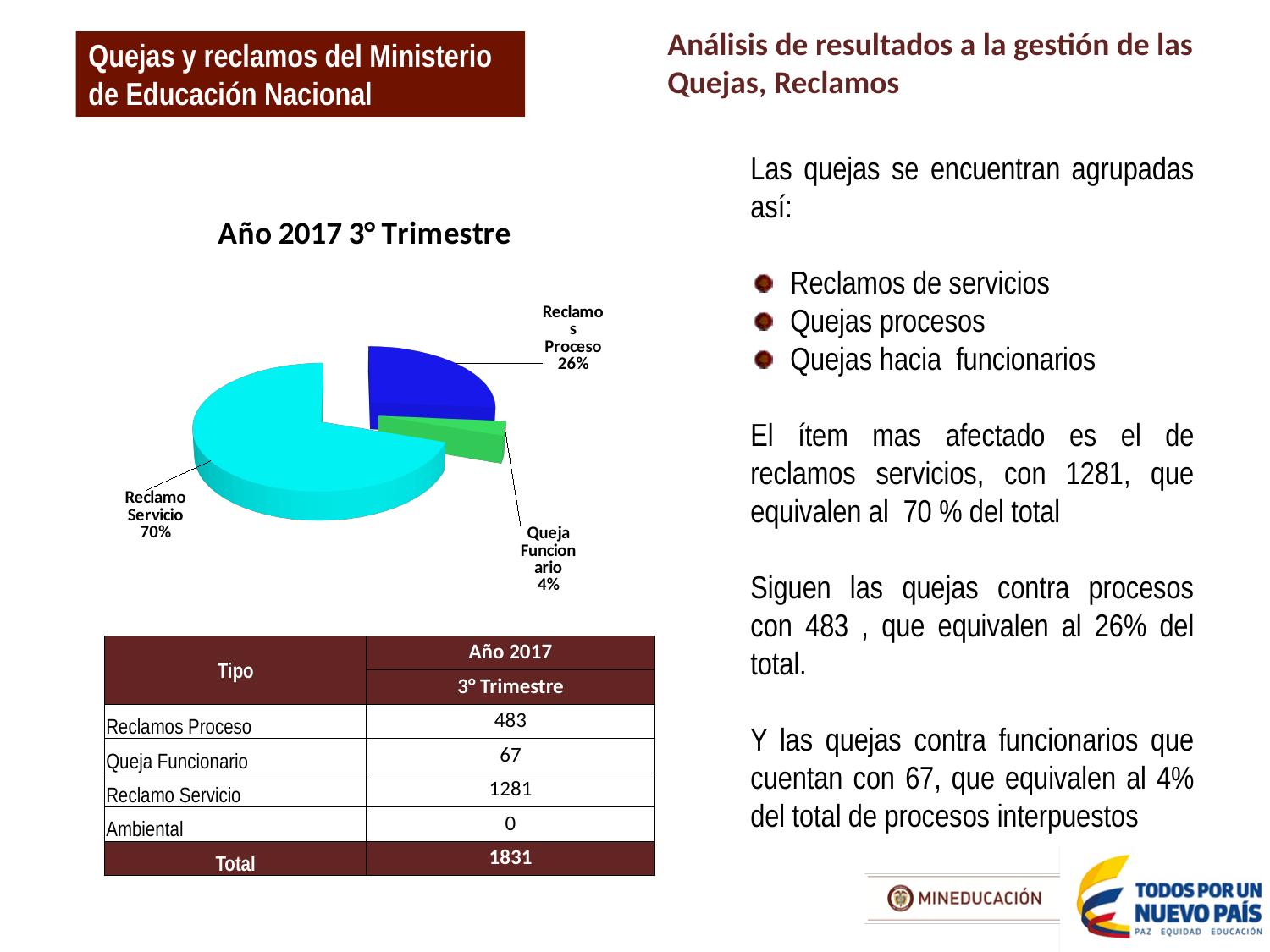
Which is larger in the pie chart, Reclamos Proceso or Queja Funcionario? Reclamos Proceso Which slice of the pie chart is the largest? Reclamo Servicio What colour is the Reclamo Servicio slice in the pie chart? cyan What share of the pie does Reclamos Proceso represent? 26% How many slices does the pie chart have? 3 What share of the pie does Reclamo Servicio represent? 70% What is the difference in percentage points between the Reclamos Proceso slice and the Queja Funcionario slice? 22 What share of the pie does Queja Funcionario represent? 4% What is the difference in percentage points between the Reclamo Servicio slice and the Reclamos Proceso slice? 44 What kind of chart is shown under the title "Año 2017 3° Trimestre"? pie chart Which slice of the pie chart is the smallest? Queja Funcionario What is the title of the pie chart? Año 2017 3° Trimestre